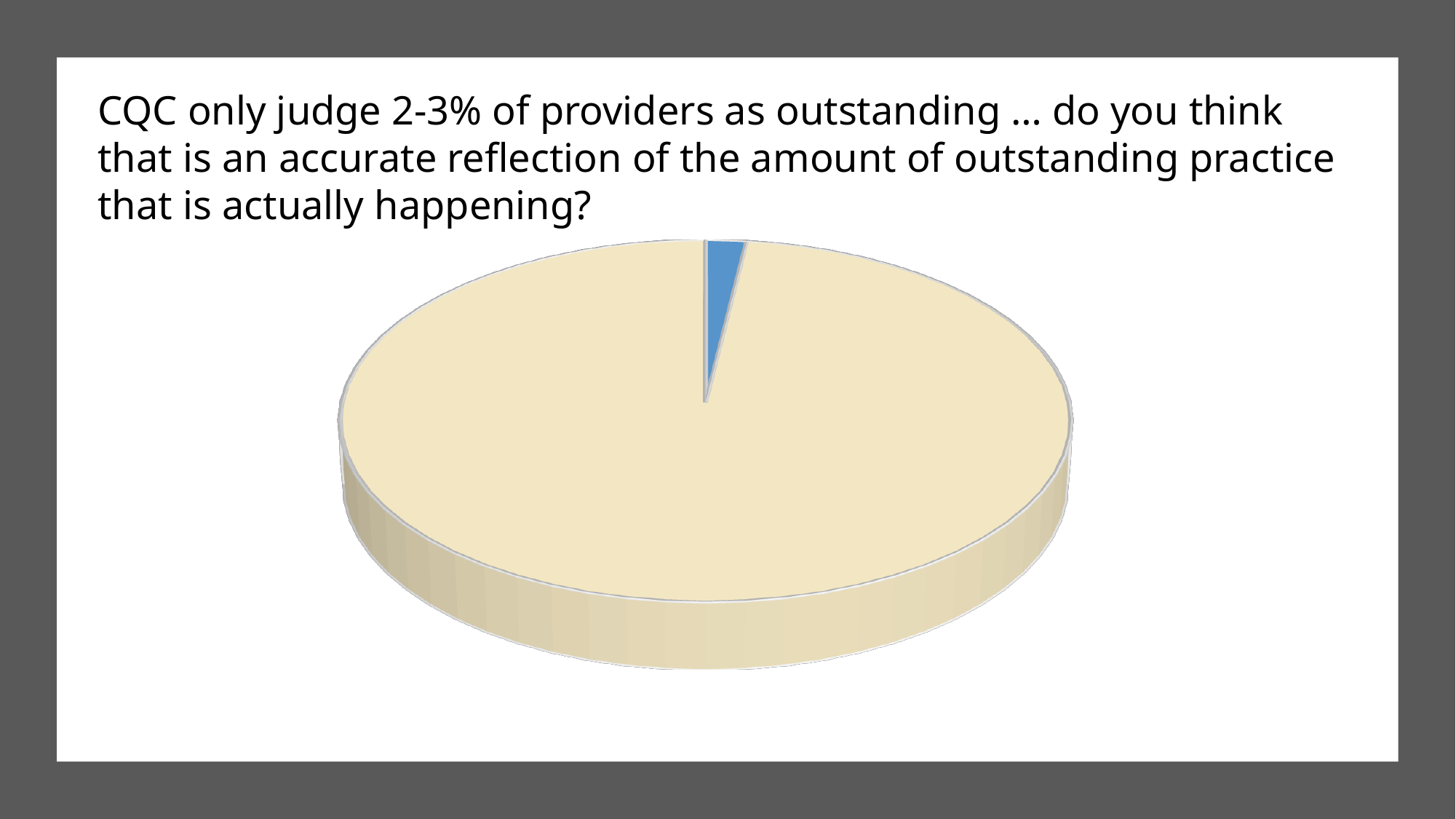
What colour is the smallest slice of the pie chart? blue How many slices does the pie chart have? 2 Which slice of the pie chart is larger, the beige slice or the blue slice? the beige slice What kind of chart is shown on the slide? pie chart According to the text above the chart, what percentage of providers does CQC judge as outstanding? 2-3%